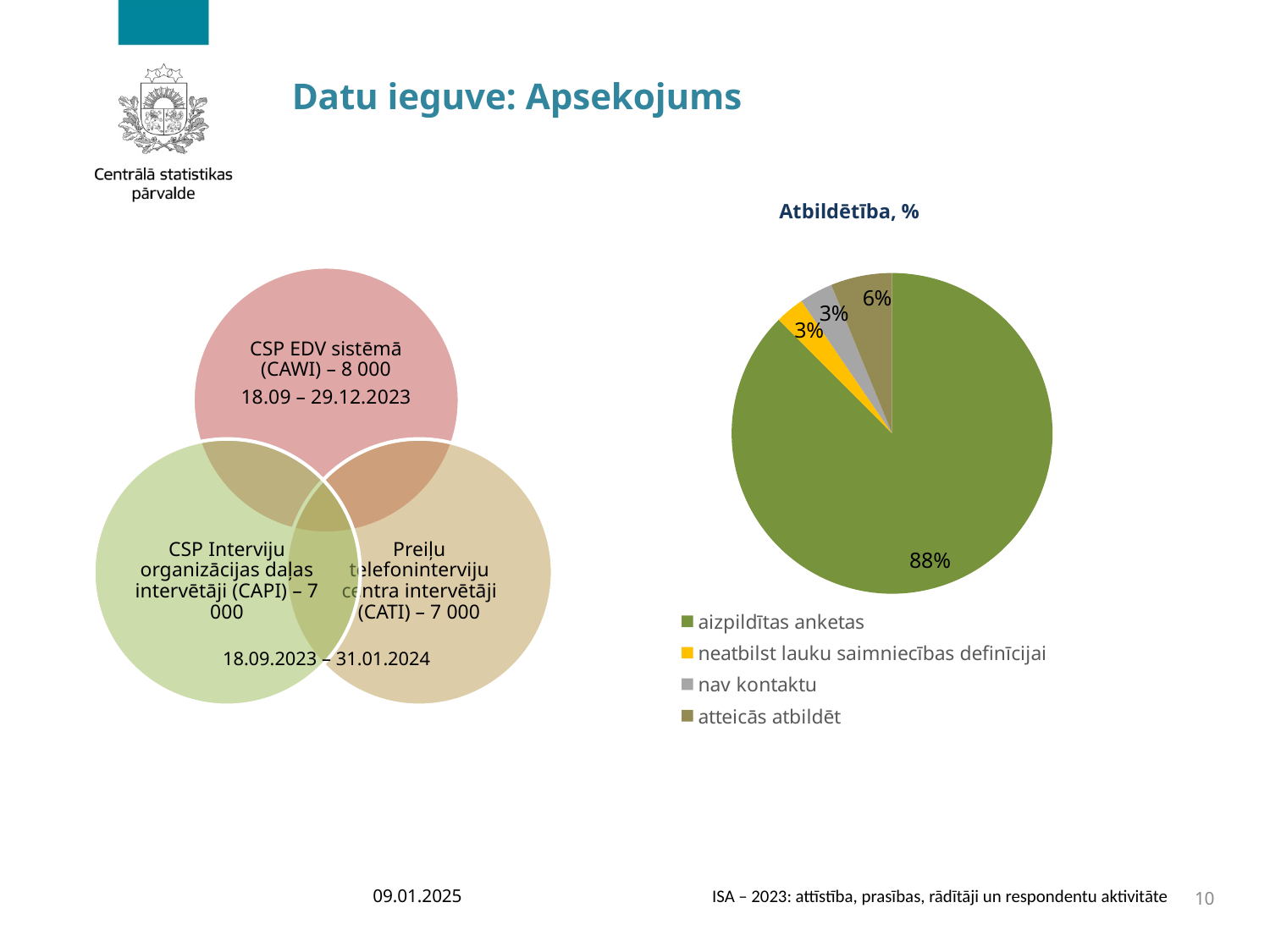
What colour is the "aizpildītas anketas" slice in the pie chart? green What type of chart is shown under the title "Atbildētība, %"? pie chart In the pie chart, which is larger: "atteicās atbildēt" or "nav kontaktu"? atteicās atbildēt In the pie chart, what is the difference between "aizpildītas anketas" and "atteicās atbildēt"? 82% What percentage of the pie chart is "neatbilst lauku saimniecības definīcijai"? 3% What is the title of the pie chart? Atbildētība, % What percentage of the pie chart is "atteicās atbildēt"? 6% What percentage of the pie chart is "aizpildītas anketas"? 88% How many entries does the legend of the pie chart list? 4 How many slices does the pie chart have? 4 What percentage of the pie chart is "nav kontaktu"? 3% Which category has the largest slice in the pie chart? aizpildītas anketas